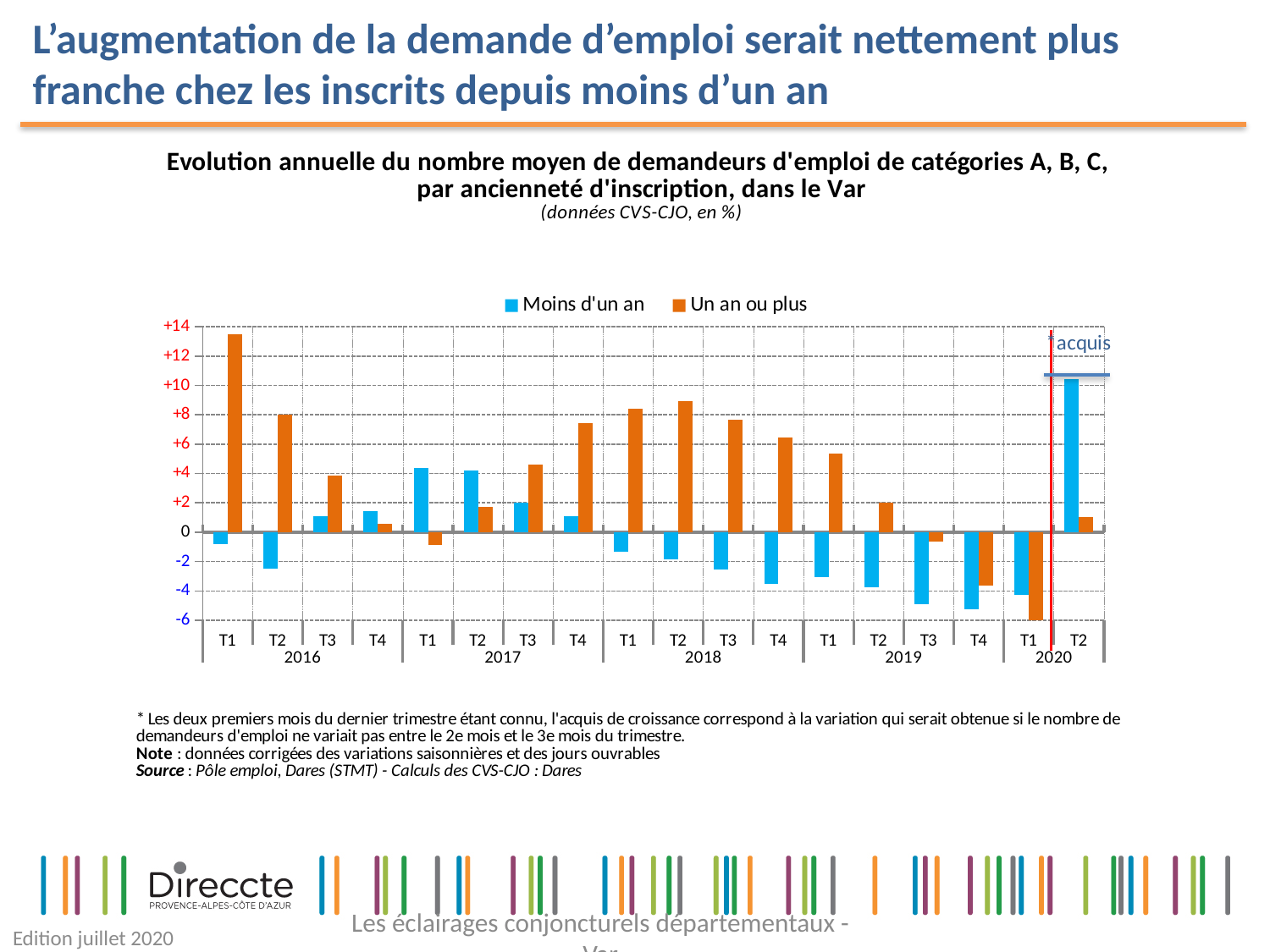
How many series does the legend list? 2 In which quarter is the value for 'Un an ou plus' lowest? T1 2020 How many quarters are plotted along the x axis? 18 In which quarter is the value for 'Un an ou plus' highest? T1 2016 What kind of chart is shown on the slide? bar chart Is the value for 'Un an ou plus' in T1 2016 greater or less than +12? greater Is the value for 'Moins d'un an' in T2 2020 greater or less than +8? greater Is the value for 'Moins d'un an' in T3 2019 greater or less than -4? less Does the value for 'Un an ou plus' rise or fall from T2 2018 to T1 2020? fall In which quarter is the value for 'Moins d'un an' highest? T2 2020 What are the two series named in the legend? Moins d'un an; Un an ou plus In T1 2017, which series has the larger value, 'Moins d'un an' or 'Un an ou plus'? Moins d'un an